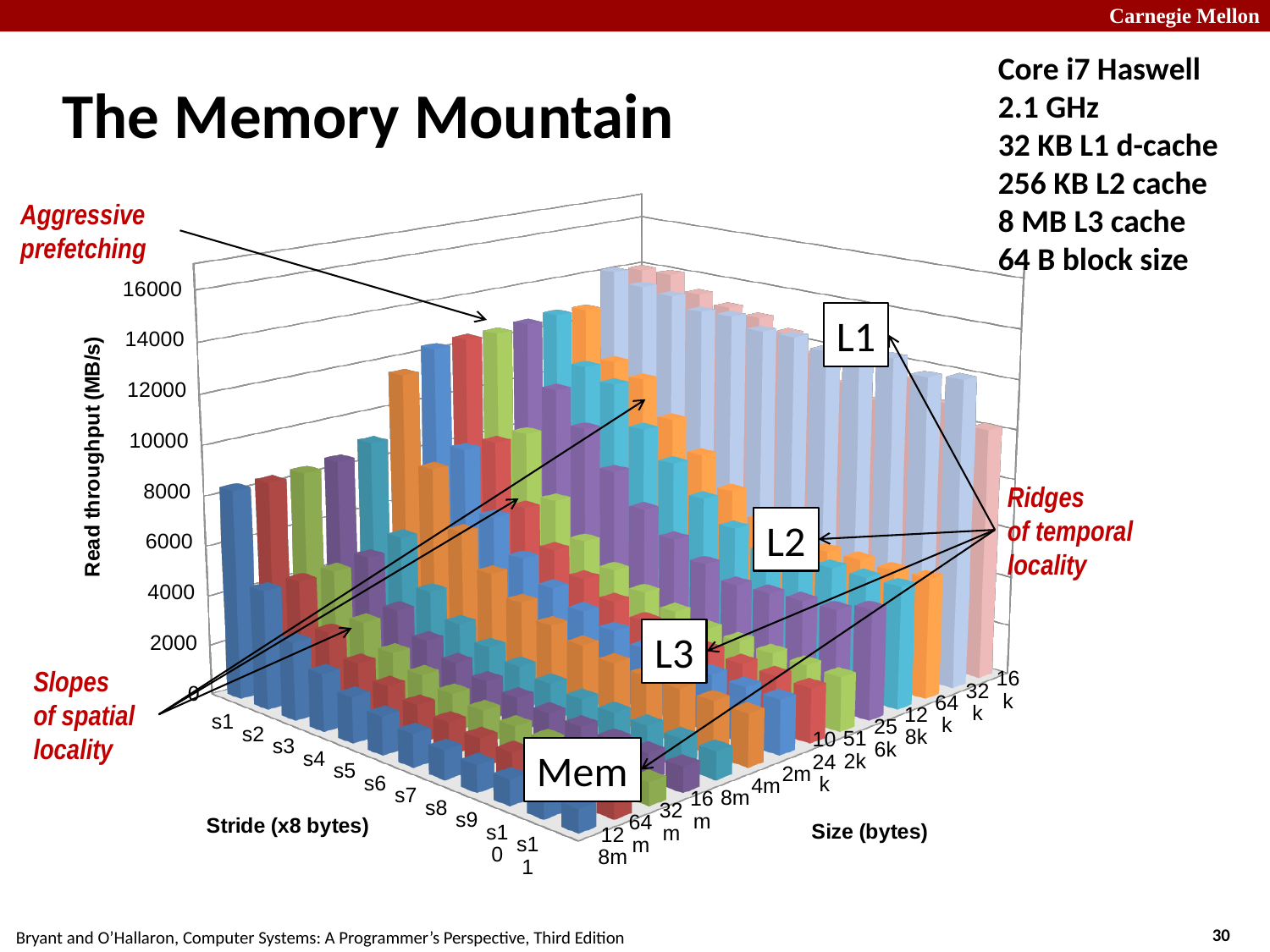
Is the read throughput for stride s1 at size 128m greater or less than 4000? greater For stride s1, which size has the higher read throughput, 128m or 16k? 16k What kind of chart is shown on the slide? 3D bar chart For the 128m size, which stride has the highest read throughput? s1 How many stride categories (s1 through s11) are shown on the stride axis? 11 What is the label of the vertical axis of the chart? Read throughput (MB/s) Is the read throughput for stride s11 at size 128m greater or less than 4000? less For the 128m size, does read throughput rise or fall as the stride increases from s1 to s11? fall What is the title of the chart on the slide? The Memory Mountain Is the read throughput for stride s1 at size 16k greater or less than 12000? greater